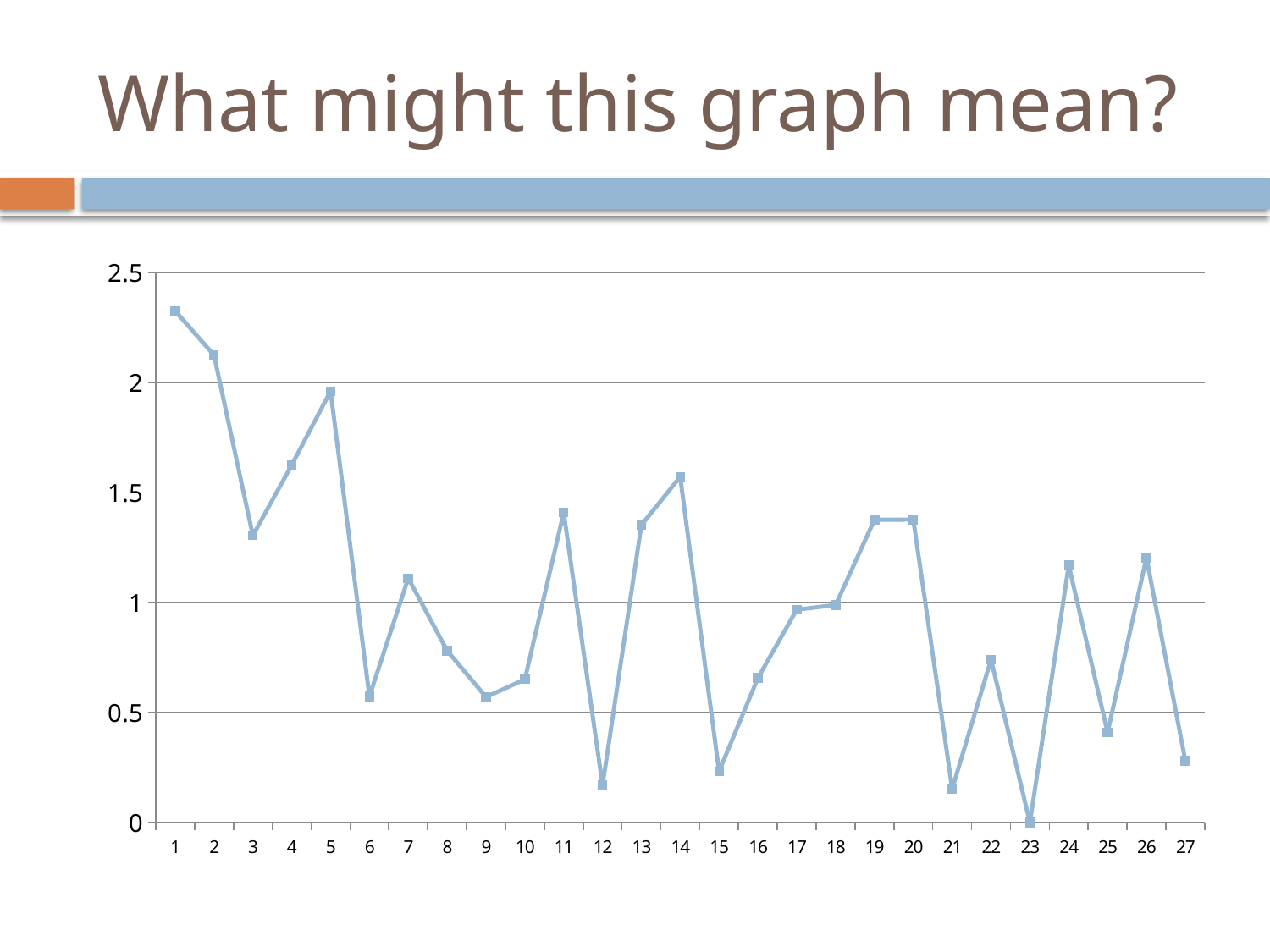
What kind of chart is shown on the slide? line chart Which x-axis category has the lowest value? 23 What is the value at category 23? 0 Which x-axis category has the highest value? 1 Is the value for category 1 greater or less than 2? greater Is the value for category 4 greater or less than 1.5? greater Is the value for category 19 greater or less than 1? greater What is the title of the slide containing the chart? What might this graph mean? Overall, do the values rise or fall from category 1 to category 27? fall How many points are plotted along the x axis? 27 Which has the larger value, category 12 or category 13? 13